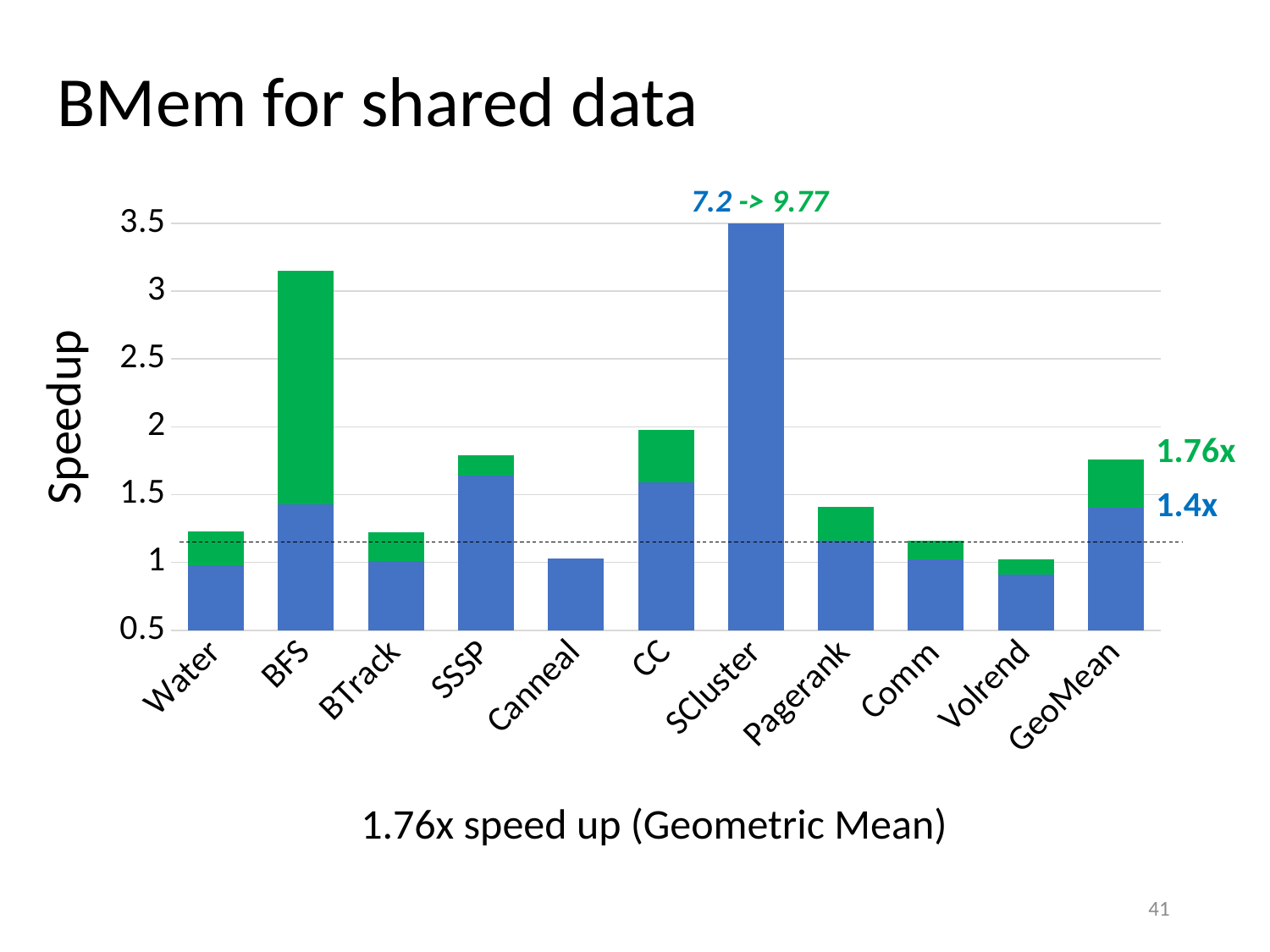
What annotation is printed above the SCluster bar? 7.2 -> 9.77 What is the label on the y axis? Speedup Is the value for Canneal greater or less than 1.5? less Which has the taller bar, Water or SSSP? SSSP What is the difference between the green and blue labelled values for GeoMean? 0.36x Which has the taller green bar, BFS or CC? BFS What speedup value is labelled in blue for GeoMean? 1.4x What kind of chart is shown on the slide? bar chart How many categories are shown on the x axis? 11 Is the top of the green bar for BFS greater or less than 3? greater Which category has the tallest bar? SCluster What speedup value is labelled in green for GeoMean? 1.76x